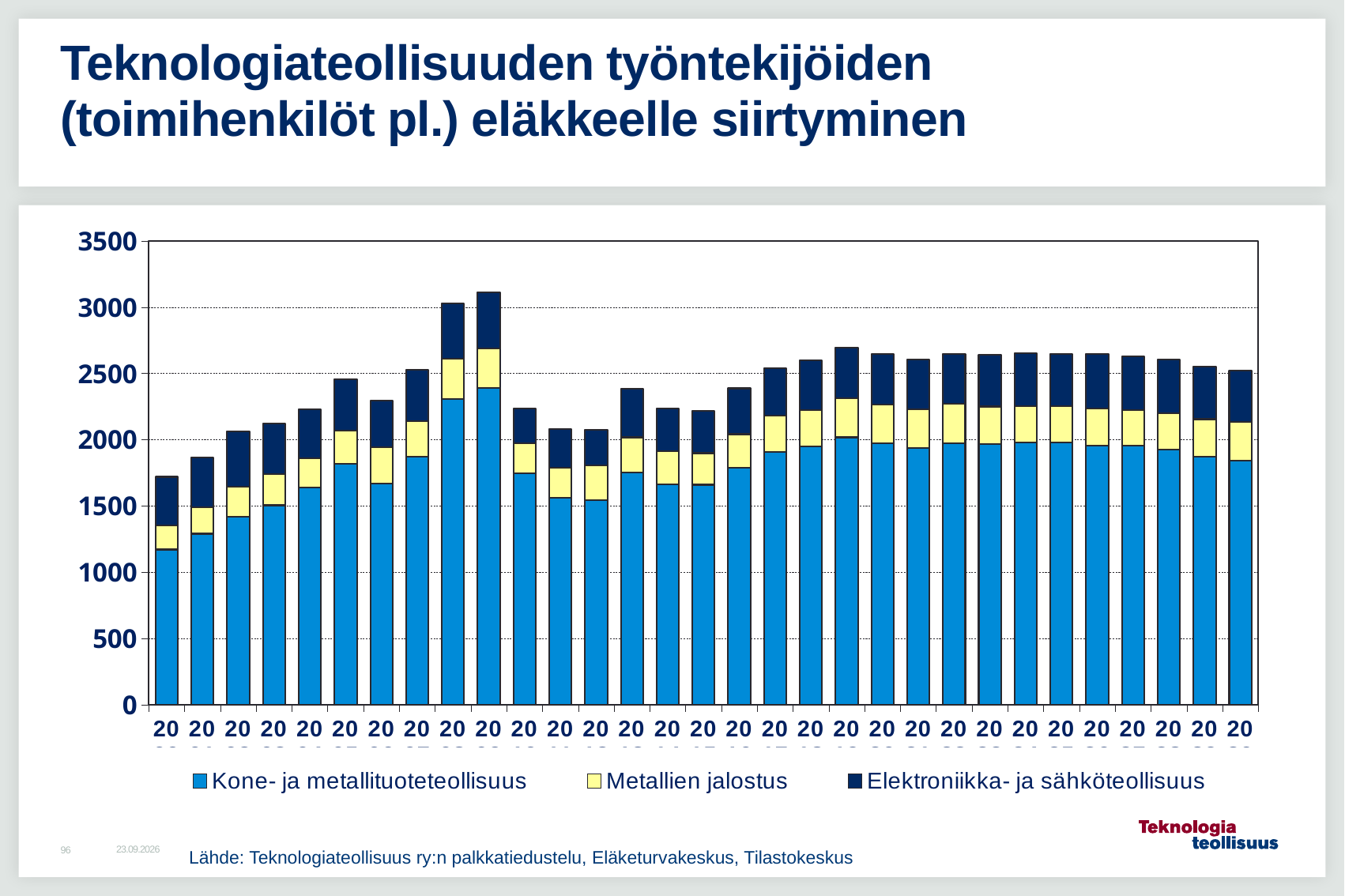
What is the title of the slide containing the chart? Teknologiateollisuuden työntekijöiden (toimihenkilöt pl.) eläkkeelle siirtyminen Is the total of the last (rightmost) stacked bar greater or less than 2000? greater In the first bar from the left, is the Kone- ja metallituoteteollisuus segment larger or smaller than the Metallien jalostus segment? larger Which series forms the largest segment in every stacked bar? Kone- ja metallituoteteollisuus How many stacked bars are plotted in the chart? 31 Is the total of the tallest stacked bar greater or less than 3500? less Is the total of the tallest stacked bar greater or less than 3000? greater What are the three series named in the legend? Kone- ja metallituoteteollisuus, Metallien jalostus, Elektroniikka- ja sähköteollisuus What kind of chart is shown on the slide? Stacked bar chart How many series does the legend list? 3